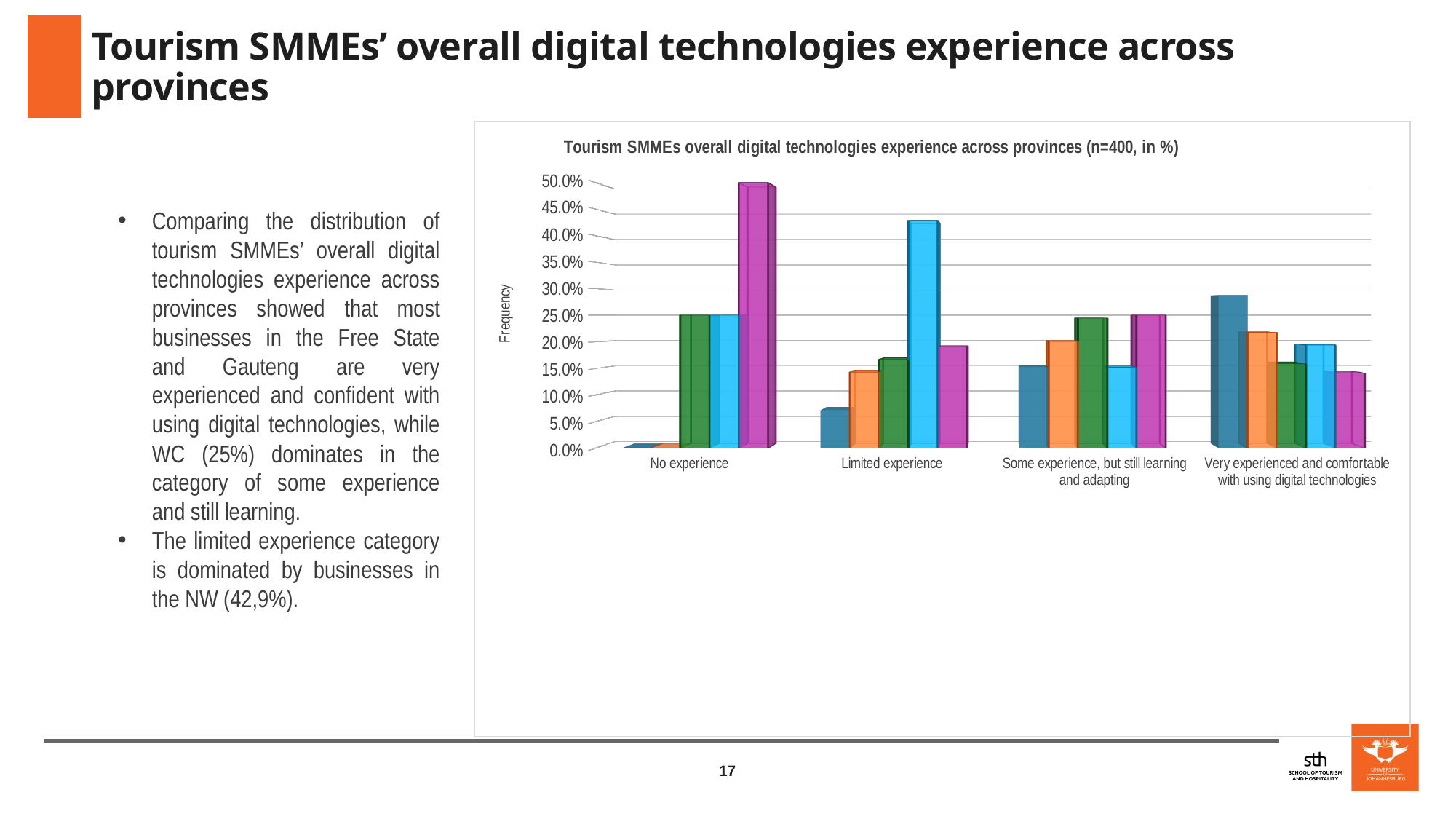
Is the value of the dark blue bar for 'No experience' greater or less than 5.0%? less Is the value of the light blue bar for 'Limited experience' greater or less than 40.0%? greater In which experience category is the magenta bar the tallest? No experience How many experience categories are shown along the x axis of the chart? 4 What is the label on the vertical axis of the chart? Frequency What kind of chart is shown on the slide? Bar chart Which coloured bar is the tallest in the 'Limited experience' category? Light blue How many bars are plotted for each experience category in the chart? 5 What is the title of the chart? Tourism SMMEs overall digital technologies experience across provinces (n=400, in %) Is the value of the dark blue bar for 'Very experienced and comfortable with using digital technologies' greater or less than 25.0%? greater In the 'Some experience, but still learning and adapting' category, which is larger: the green bar or the dark blue bar? Green bar